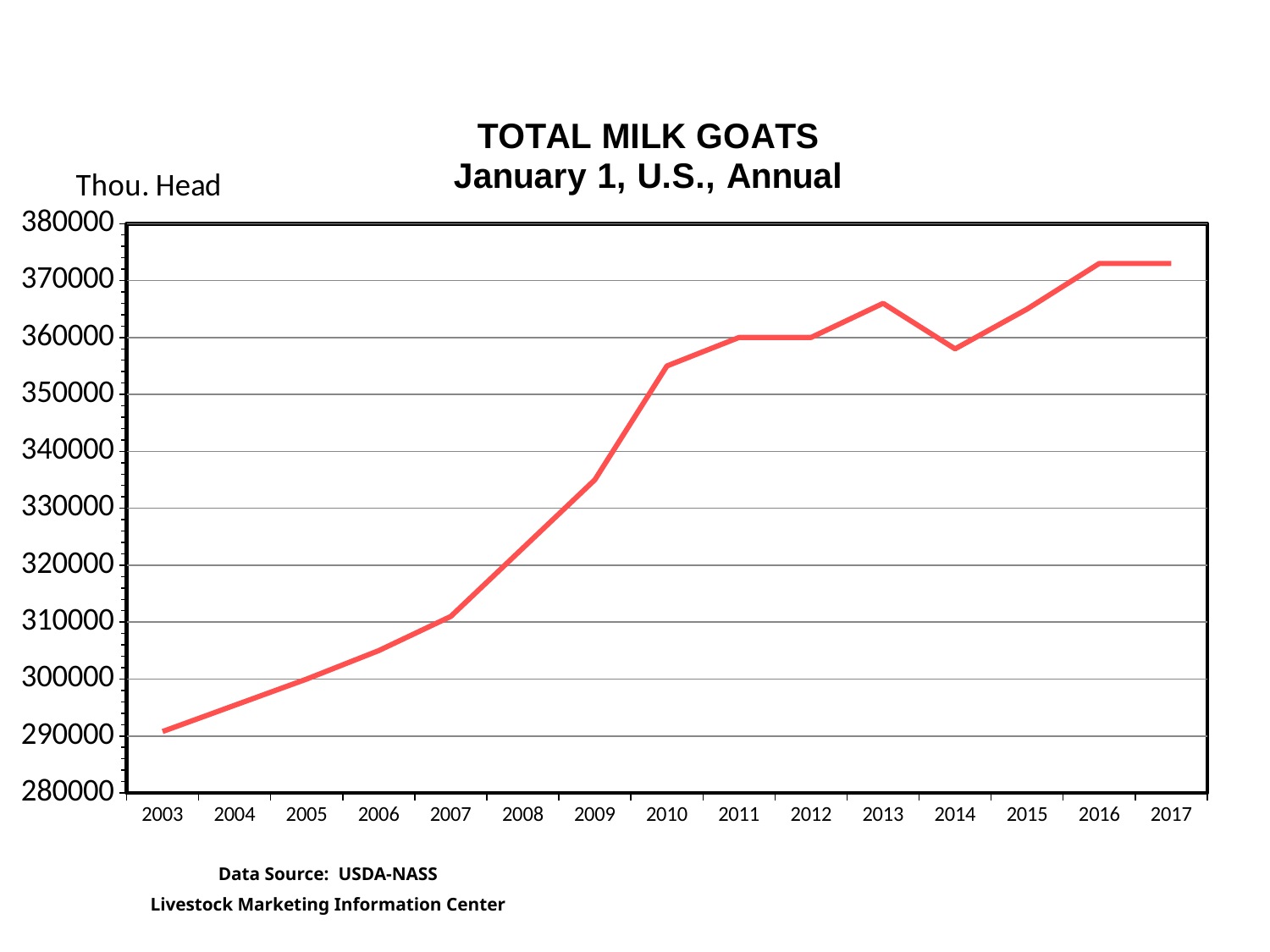
What is the label on the y axis of the chart? Thou. Head What kind of chart is shown on the slide? line chart Which year has the lowest value for total milk goats? 2003 Is the value for 2009 greater or less than 340000? less Do the values generally rise or fall from 2003 to 2017? rise Is the value for 2010 greater or less than 350000? greater What is the title of the chart? TOTAL MILK GOATS January 1, U.S., Annual Is the value for 2016 greater or less than 370000? greater How many years are plotted on the x axis? 15 Which year has the larger value, 2013 or 2014? 2013